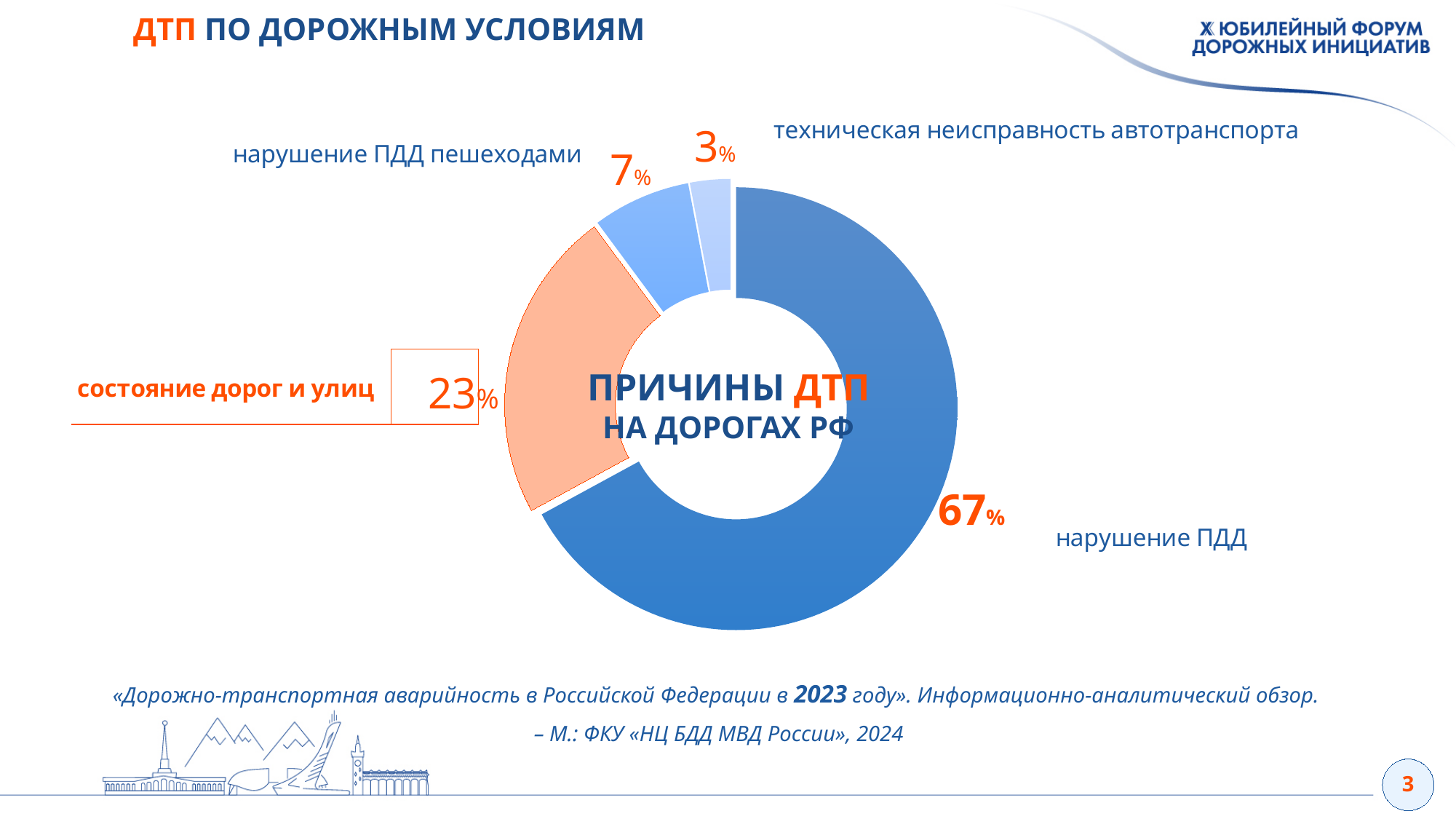
What kind of chart is shown on the slide? pie (donut) chart What share of accidents is attributed to нарушение ПДД пешеходами? 7% What is the difference in percentage points between нарушение ПДД and состояние дорог и улиц? 44 Which cause has the largest share in the chart? нарушение ПДД What is the difference in percentage points between нарушение ПДД пешеходами and техническая неисправность автотранспорта? 4 What share of accidents is attributed to состояние дорог и улиц? 23% What share of accidents is attributed to техническая неисправность автотранспорта? 3% How many causes (slices) are shown in the chart? 4 What share of accidents is attributed to нарушение ПДД? 67% Which cause has the smallest share in the chart? техническая неисправность автотранспорта Which is larger: the share for состояние дорог и улиц or the share for нарушение ПДД пешеходами? состояние дорог и улиц What is the title written in the centre of the chart? ПРИЧИНЫ ДТП НА ДОРОГАХ РФ